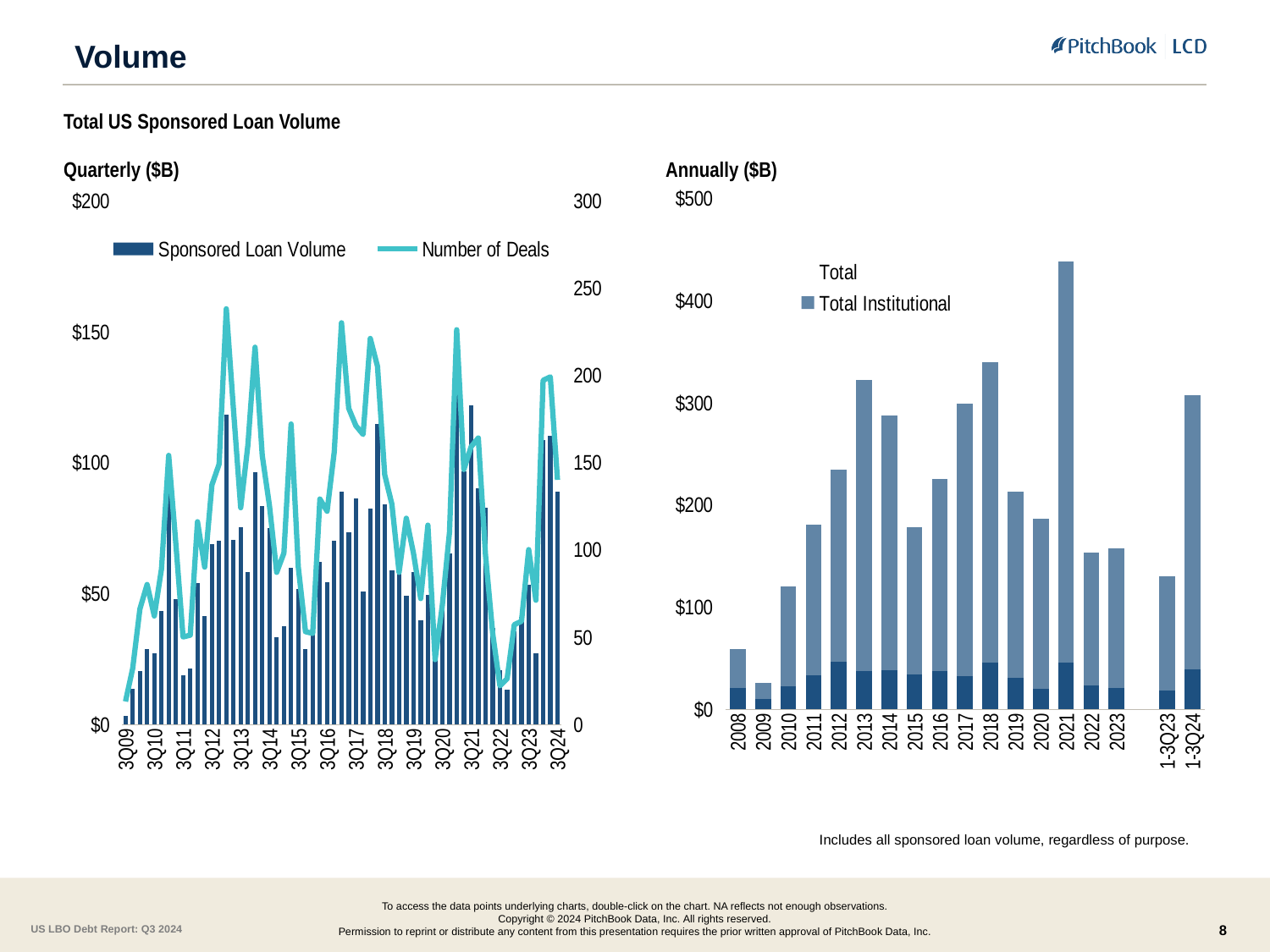
In the Annually ($B) chart, which year has the highest total sponsored loan volume? 2021 In the Annually ($B) chart, is the total value for 2021 greater or less than $400? greater In the Annually ($B) chart, which has the larger total: 1-3Q23 or 1-3Q24? 1-3Q24 In the Annually ($B) chart, is the total value for 2022 greater or less than $200? less In the Annually ($B) chart, is the total value for 2018 greater or less than $300? greater How many series does the legend of the Annually ($B) chart list? 2 In the Annually ($B) chart, which has the larger total: 2013 or 2014? 2013 What kind of chart is the Annually ($B) chart? Stacked bar chart What are the two series listed in the legend of the Quarterly ($B) chart? Sponsored Loan Volume and Number of Deals In the Annually ($B) chart, which year has the lowest total sponsored loan volume? 2009